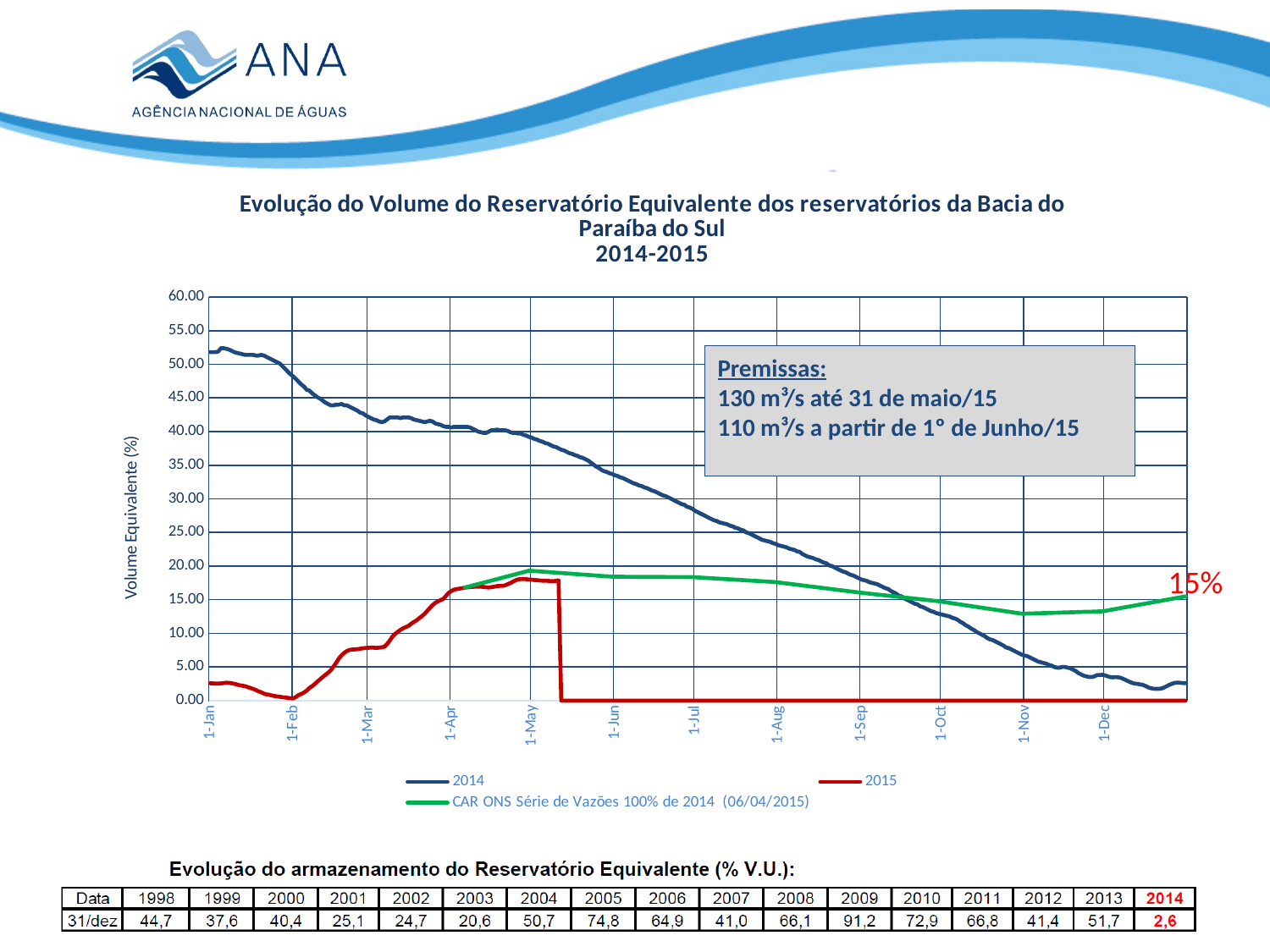
What kind of chart is shown on the slide? line chart How many series does the chart legend list? 3 What is the label of the vertical axis of the chart? Volume Equivalente (%) Is the value of the 2014 series at 1-Dec greater or less than 5? less At 1-Nov, which series has the larger value, 2014 or CAR ONS Série de Vazões 100% de 2014? CAR ONS Série de Vazões 100% de 2014 Does the 2014 series rise or fall from 1-Jan to 1-Dec? fall Is the value of the 2014 series at 1-Sep greater or less than 20? less At 1-Jan, which series has the larger value, 2014 or 2015? 2014 Is the value of the 2015 series at 1-May greater or less than 15? greater What value is labelled at the end of the green CAR ONS line? 15%